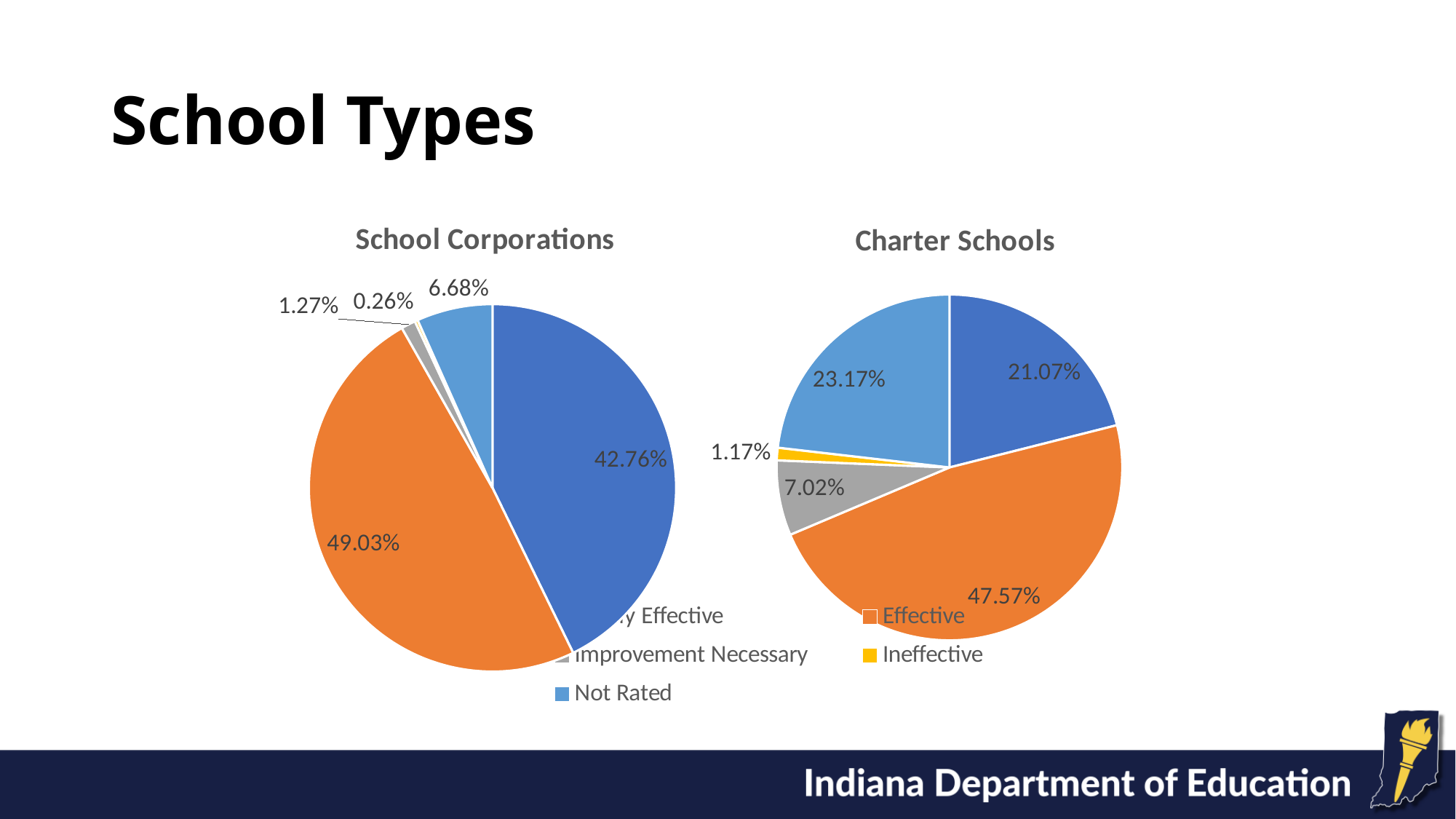
In the Charter Schools chart, what share of the pie is Not Rated? 23.17% In the School Corporations chart, what share of the pie is Improvement Necessary? 1.27% How many slices does the Charter Schools pie chart have? 5 In the School Corporations chart, what share of the pie is Ineffective? 0.26% What is the difference between the Effective share in the School Corporations chart and the Effective share in the Charter Schools chart? 1.46% In the Charter Schools chart, which is larger, the Not Rated slice or the Improvement Necessary slice? Not Rated What kind of charts are shown on the slide? Pie charts In the Charter Schools chart, which category has the smallest slice? Ineffective